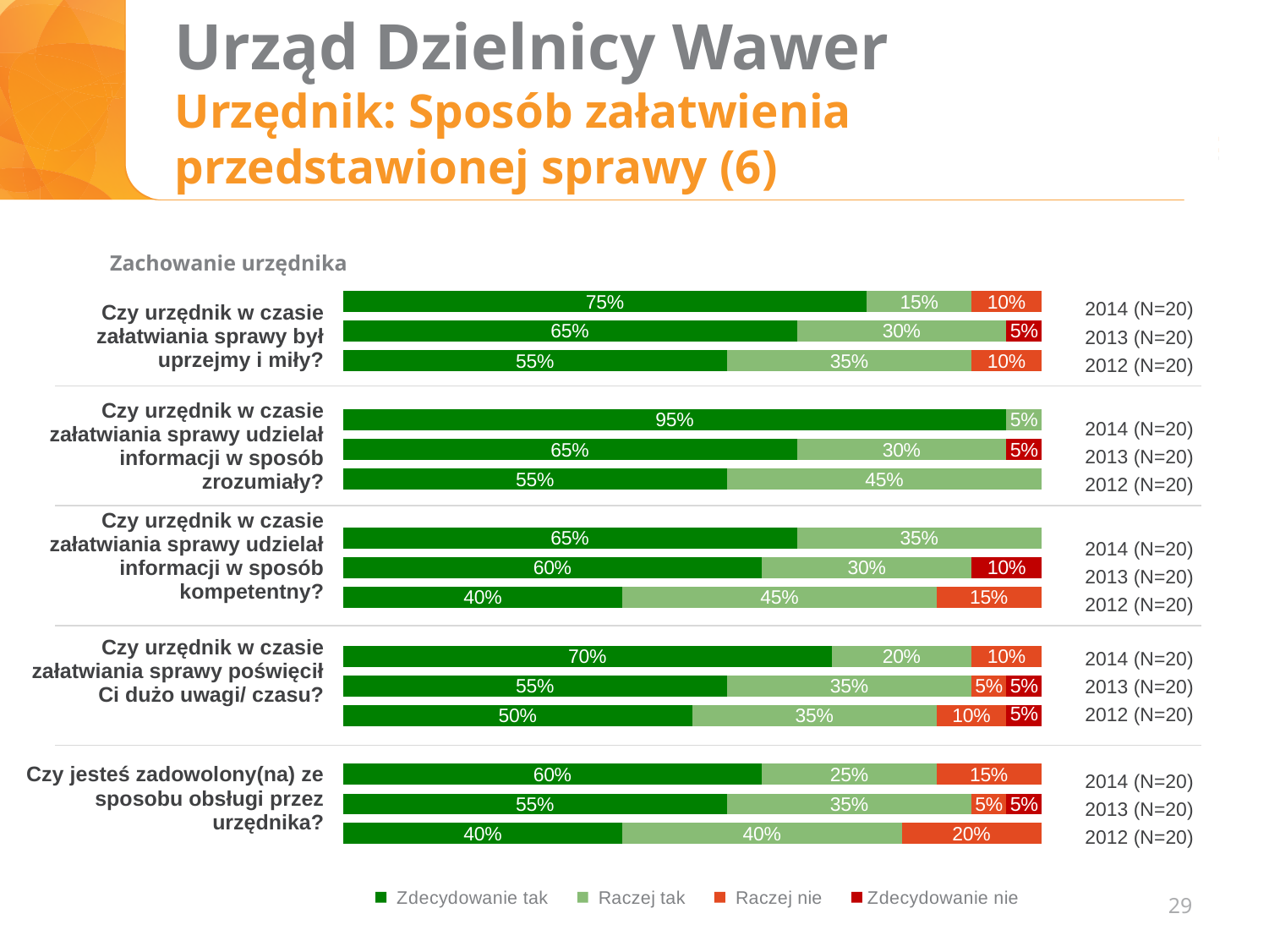
In the chart for 'Czy urzędnik w czasie załatwiania sprawy poświęcił Ci dużo uwagi/ czasu?', which year has the larger 'Zdecydowanie tak' value, 2013 or 2012? 2013 (N=20) What sample size (N) is shown for each year on the slide? N=20 In the chart for 'Czy urzędnik w czasie załatwiania sprawy był uprzejmy i miły?', does the 'Zdecydowanie tak' value rise or fall from 2012 to 2014? Rises What kind of chart is used on this slide? Stacked bar chart How many series does the legend at the bottom of the slide list? 4 In the chart for 'Czy urzędnik w czasie załatwiania sprawy udzielał informacji w sposób zrozumiały?', what is the 'Raczej tak' value for 2013 (N=20)? 30% In the chart for 'Czy urzędnik w czasie załatwiania sprawy udzielał informacji w sposób kompetentny?', what is the difference between the 'Zdecydowanie tak' values for 2014 and 2012? 25 percentage points In the chart for 'Czy urzędnik w czasie załatwiania sprawy udzielał informacji w sposób zrozumiały?', which year has the highest 'Zdecydowanie tak' value? 2014 (N=20) In the chart for 'Czy jesteś zadowolony(na) ze sposobu obsługi przez urzędnika?', what is the 'Raczej tak' value for 2012 (N=20)? 40% In the chart for 'Czy urzędnik w czasie załatwiania sprawy był uprzejmy i miły?', what is the 'Zdecydowanie tak' value for 2014 (N=20)? 75% How many years (bars) are shown for each question on the slide? 3 In the chart for 'Czy jesteś zadowolony(na) ze sposobu obsługi przez urzędnika?', which year has the lowest 'Zdecydowanie tak' value? 2012 (N=20)